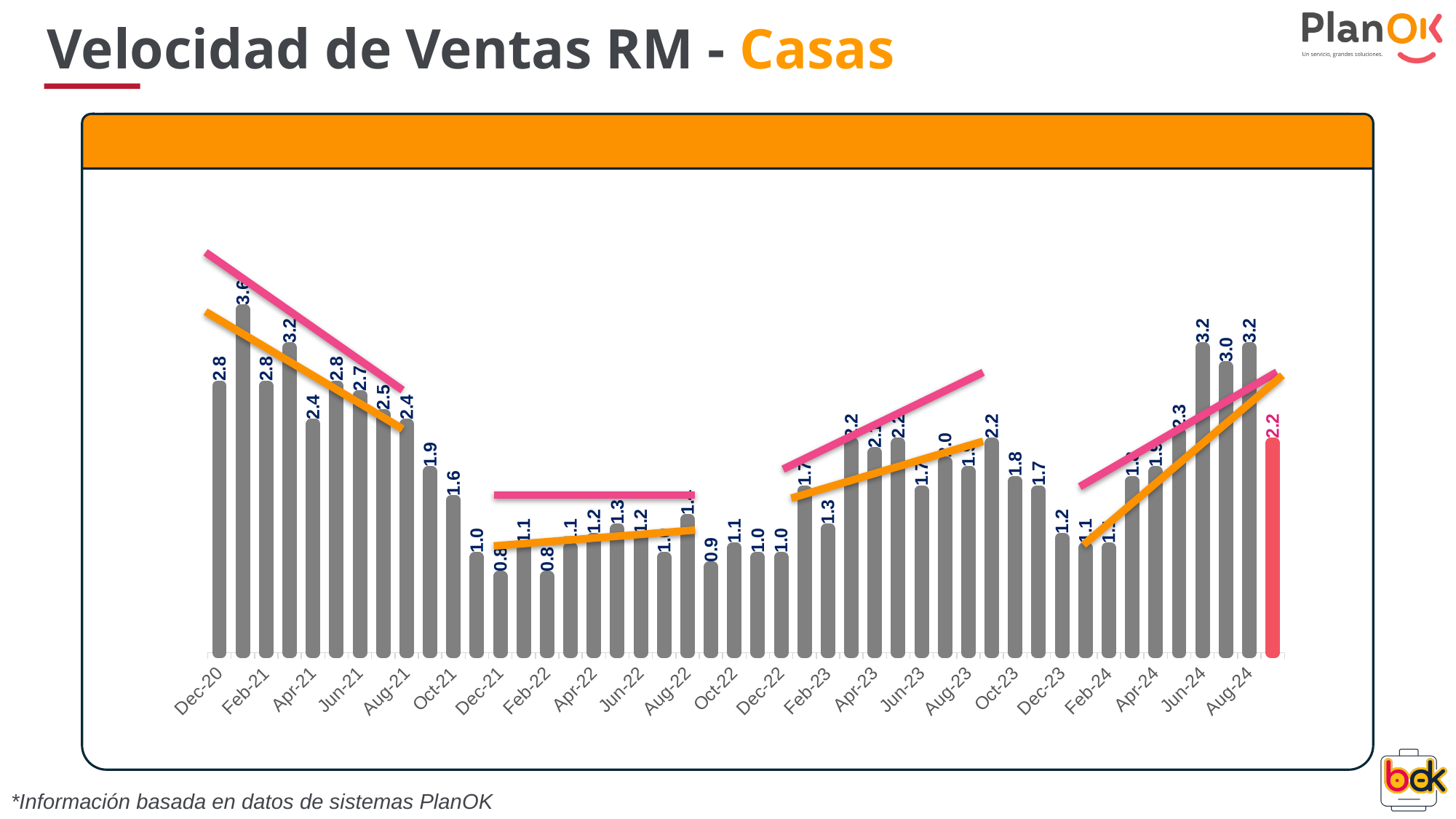
Do the values rise or fall from Dec-20 to Oct-21? fall What is the value labelled on the red bar at the right end of the chart? 2.2 What is the value for Oct-21? 1.6 What is the highest value labelled on any bar in the chart? 3.6 What is the value for Dec-23? 1.2 What is the value for Dec-20? 2.8 What is the value for Jun-24? 3.2 What is the lowest value labelled on any bar in the chart? 0.8 What is the difference between the values for Jun-24 and Dec-23? 2.0 What is the value for Dec-21? 0.8 Which is larger, the value for Aug-24 or the value for Feb-22? Aug-24 What kind of chart is shown on the slide? bar chart